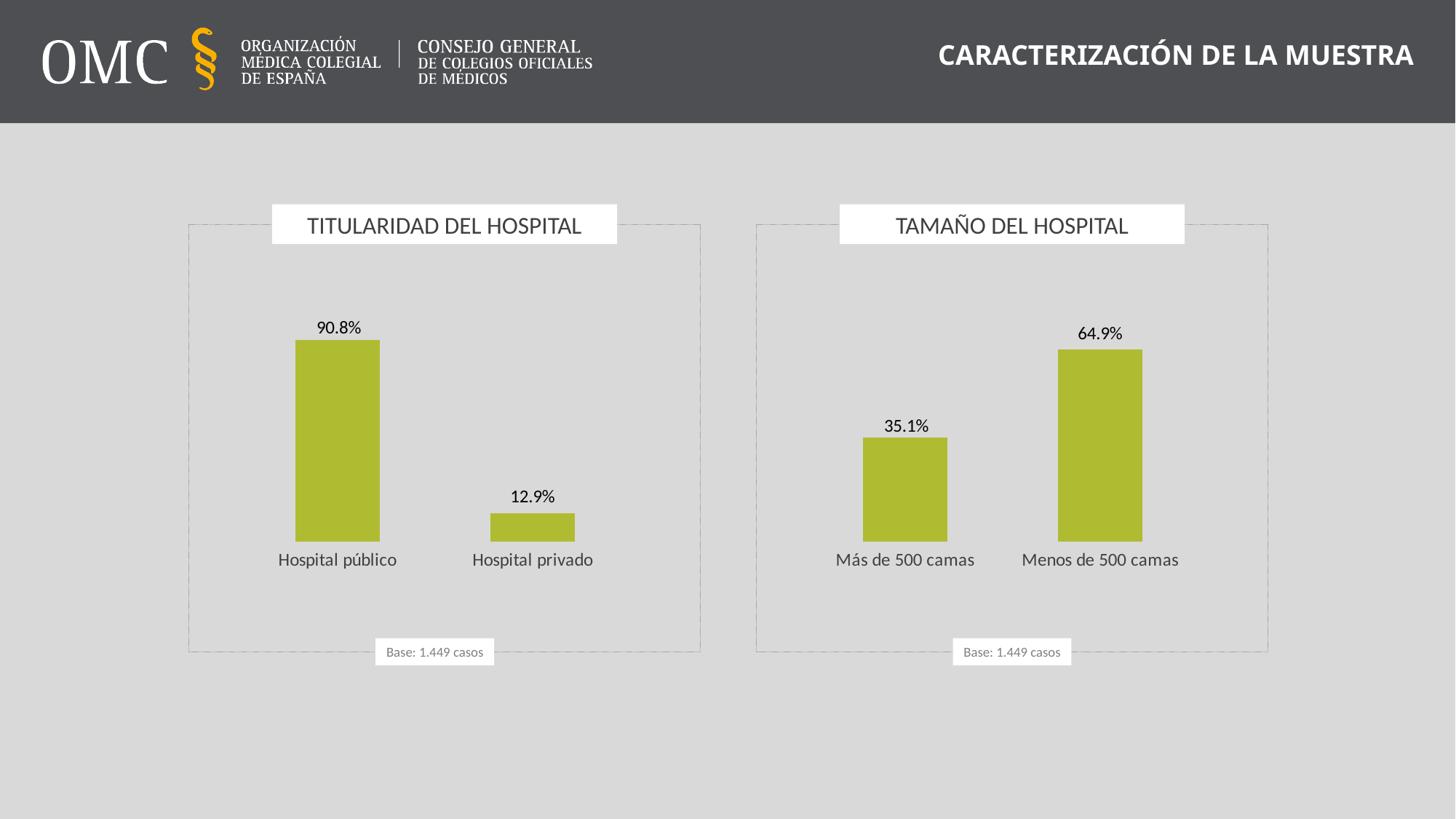
In the 'TAMAÑO DEL HOSPITAL' chart, what is the difference between Menos de 500 camas and Más de 500 camas? 29.8% In the 'TITULARIDAD DEL HOSPITAL' chart, what is the difference between Hospital público and Hospital privado? 77.9% In the 'TITULARIDAD DEL HOSPITAL' chart, which category has the highest value? Hospital público In the 'TAMAÑO DEL HOSPITAL' chart, what is the value for Más de 500 camas? 35.1% In the 'TAMAÑO DEL HOSPITAL' chart, what is the value for Menos de 500 camas? 64.9% In the 'TITULARIDAD DEL HOSPITAL' chart, what is the value for Hospital público? 90.8% In the 'TAMAÑO DEL HOSPITAL' chart, which category has the lowest value? Más de 500 camas In the 'TITULARIDAD DEL HOSPITAL' chart, what is the value for Hospital privado? 12.9% What base (number of cases) is shown below the 'TITULARIDAD DEL HOSPITAL' chart? 1.449 casos How many categories are shown in the 'TITULARIDAD DEL HOSPITAL' chart? 2 In the 'TAMAÑO DEL HOSPITAL' chart, which is larger: Más de 500 camas or Menos de 500 camas? Menos de 500 camas What kind of chart is the 'TAMAÑO DEL HOSPITAL' chart? Bar chart